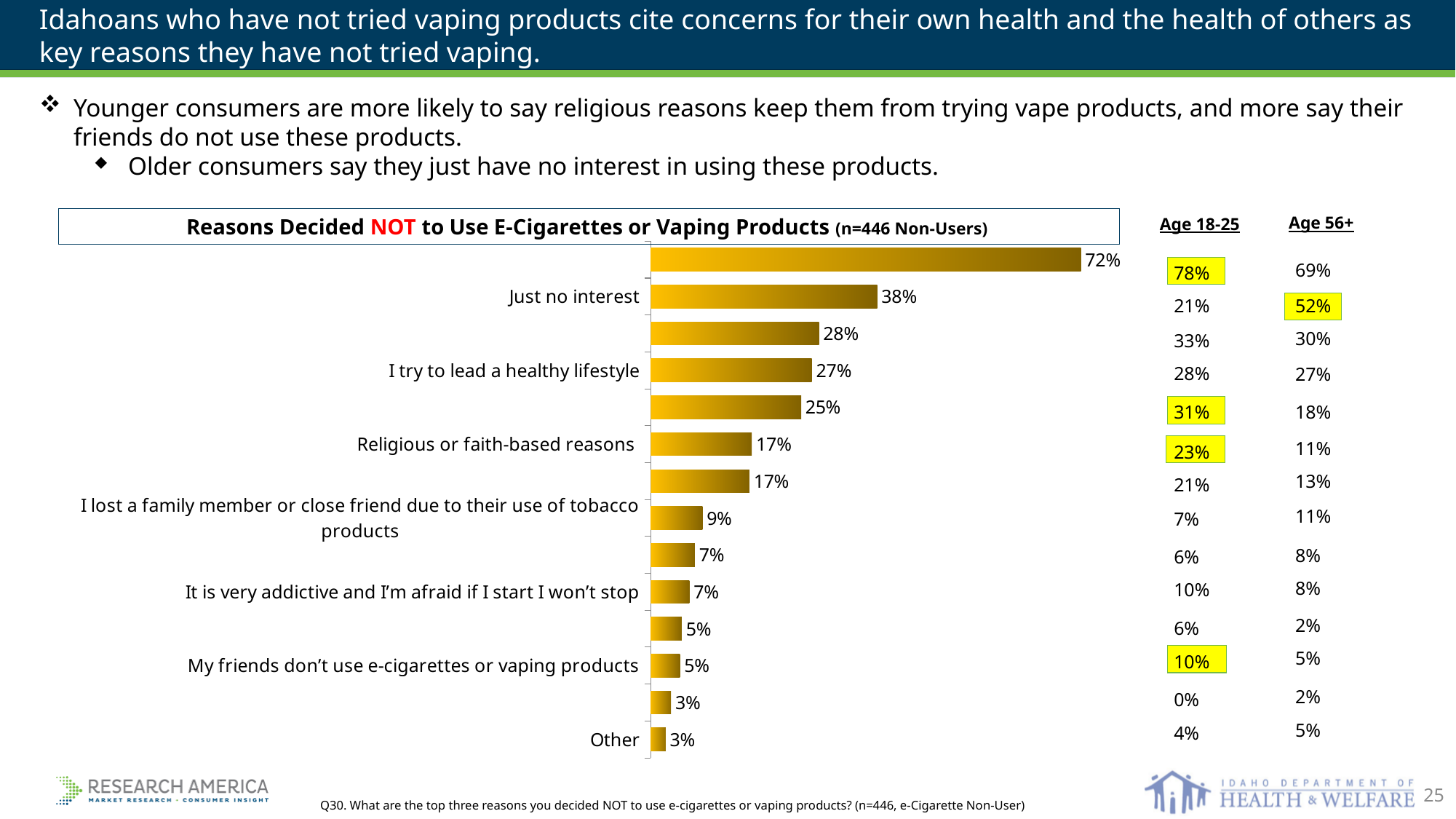
What is the value for "My friends don't use e-cigarettes or vaping products"? 5% What percentage of non-users cite "Just no interest" as a reason for not using e-cigarettes or vaping products? 38% What is the value for "I lost a family member or close friend due to their use of tobacco products"? 9% According to the chart title, how many non-users were surveyed? 446 What is the difference in percentage points between "Just no interest" and "I try to lead a healthy lifestyle"? 11 percentage points Which has a higher value: "Religious or faith-based reasons" or "It is very addictive and I'm afraid if I start I won't stop"? Religious or faith-based reasons What type of chart is used to show the reasons for not using e-cigarettes or vaping products? Bar chart What percentage is shown for "Other"? 3% What percentage is shown for "It is very addictive and I'm afraid if I start I won't stop"? 7% What percentage is shown for "Religious or faith-based reasons"? 17% What is the value shown for "I try to lead a healthy lifestyle"? 27% How many bars are plotted in the chart? 14